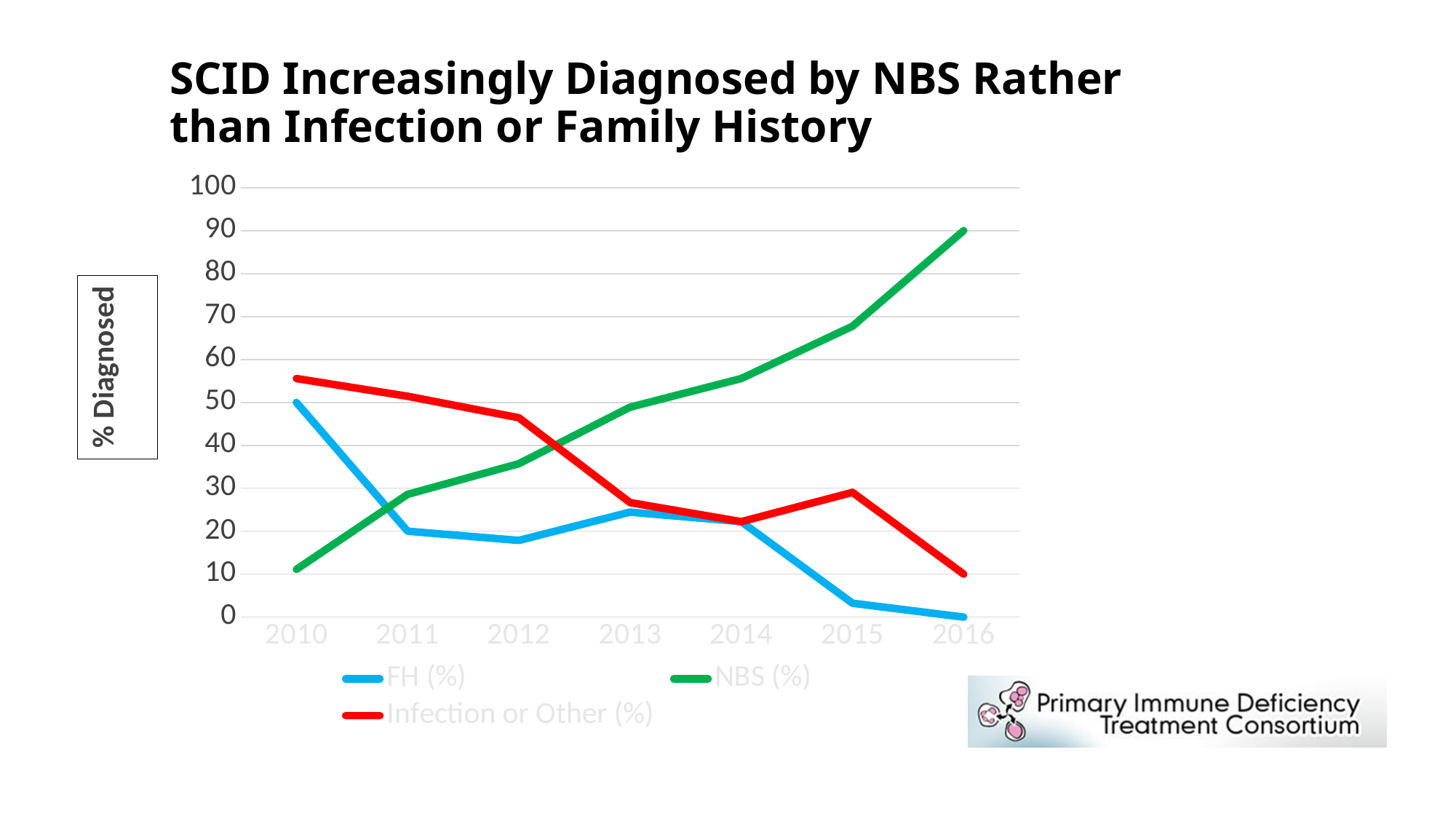
Is the value for NBS (%) in 2014 greater or less than 50? greater Does the FH (%) line rise or fall overall from 2010 to 2016? falls How many years are shown along the x axis? 7 Does the NBS (%) line rise or fall from 2010 to 2016? rises Which series has the highest value in 2016? NBS (%) What kind of chart is shown on the slide? line chart How many series does the legend list? 3 Which series has the lowest value in 2010? NBS (%) What is the value for FH (%) in 2016? 0 What is the label on the y axis? % Diagnosed Is the value for Infection or Other (%) in 2016 greater or less than 20? less In 2015, which is larger: the value for NBS (%) or the value for Infection or Other (%)? NBS (%)